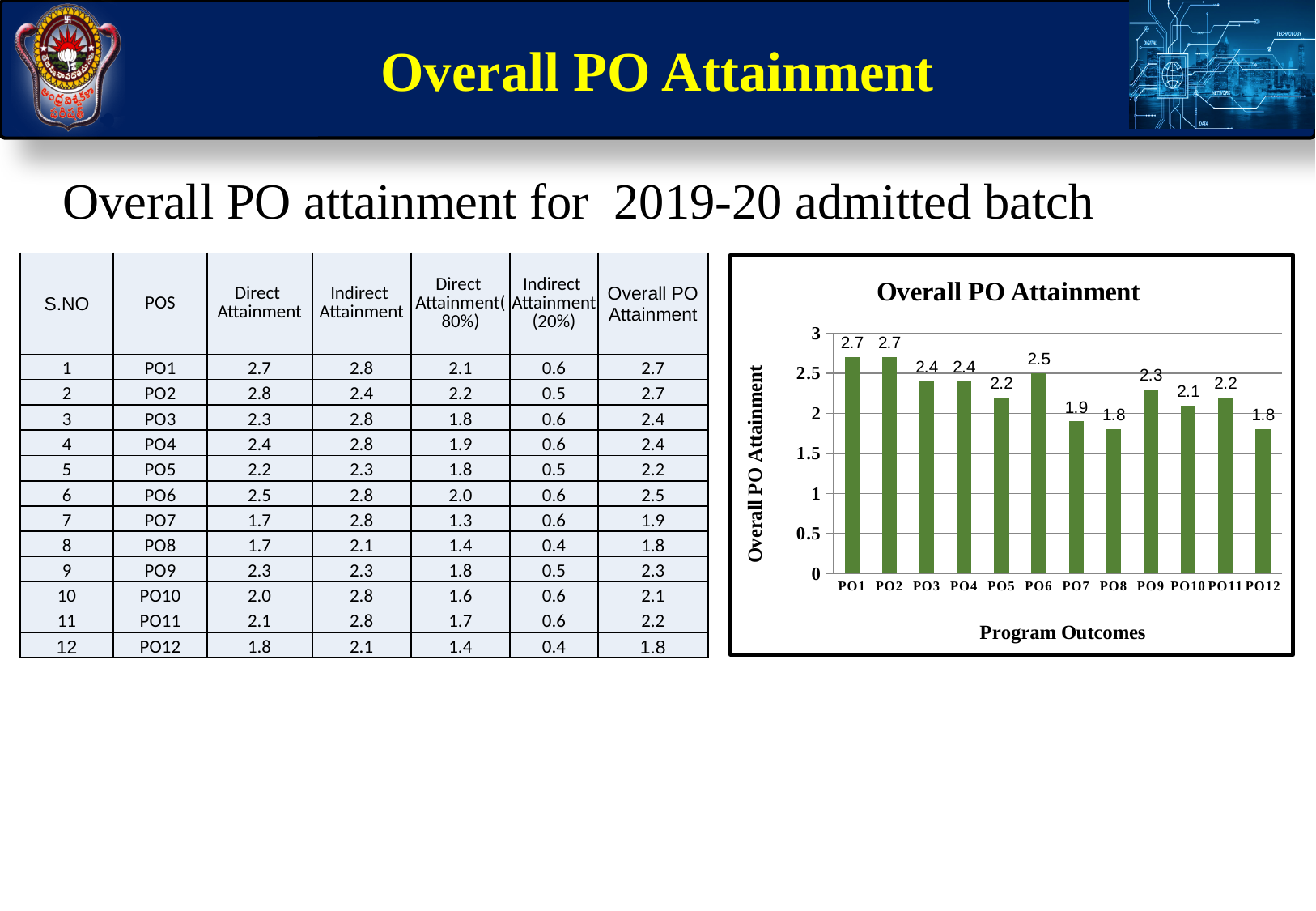
Which program outcome has the lowest value in the Overall PO Attainment chart? PO8 and PO12 (both 1.8) What is the difference between the values for PO1 and PO7 in the Overall PO Attainment chart? 0.8 What is the value for PO6 in the Overall PO Attainment chart? 2.5 What is the difference between the values for PO6 and PO5 in the Overall PO Attainment chart? 0.3 What is the value for PO10 in the Overall PO Attainment chart? 2.1 Is the value for PO8 in the Overall PO Attainment chart greater or less than 2? less What colour are the bars in the Overall PO Attainment chart? green Which is larger in the Overall PO Attainment chart, the value for PO3 or the value for PO7? PO3 What is the x-axis title of the Overall PO Attainment chart? Program Outcomes How many program outcomes are plotted in the Overall PO Attainment chart? 12 What is the value for PO9 in the Overall PO Attainment chart? 2.3 What kind of chart is the Overall PO Attainment chart? bar chart